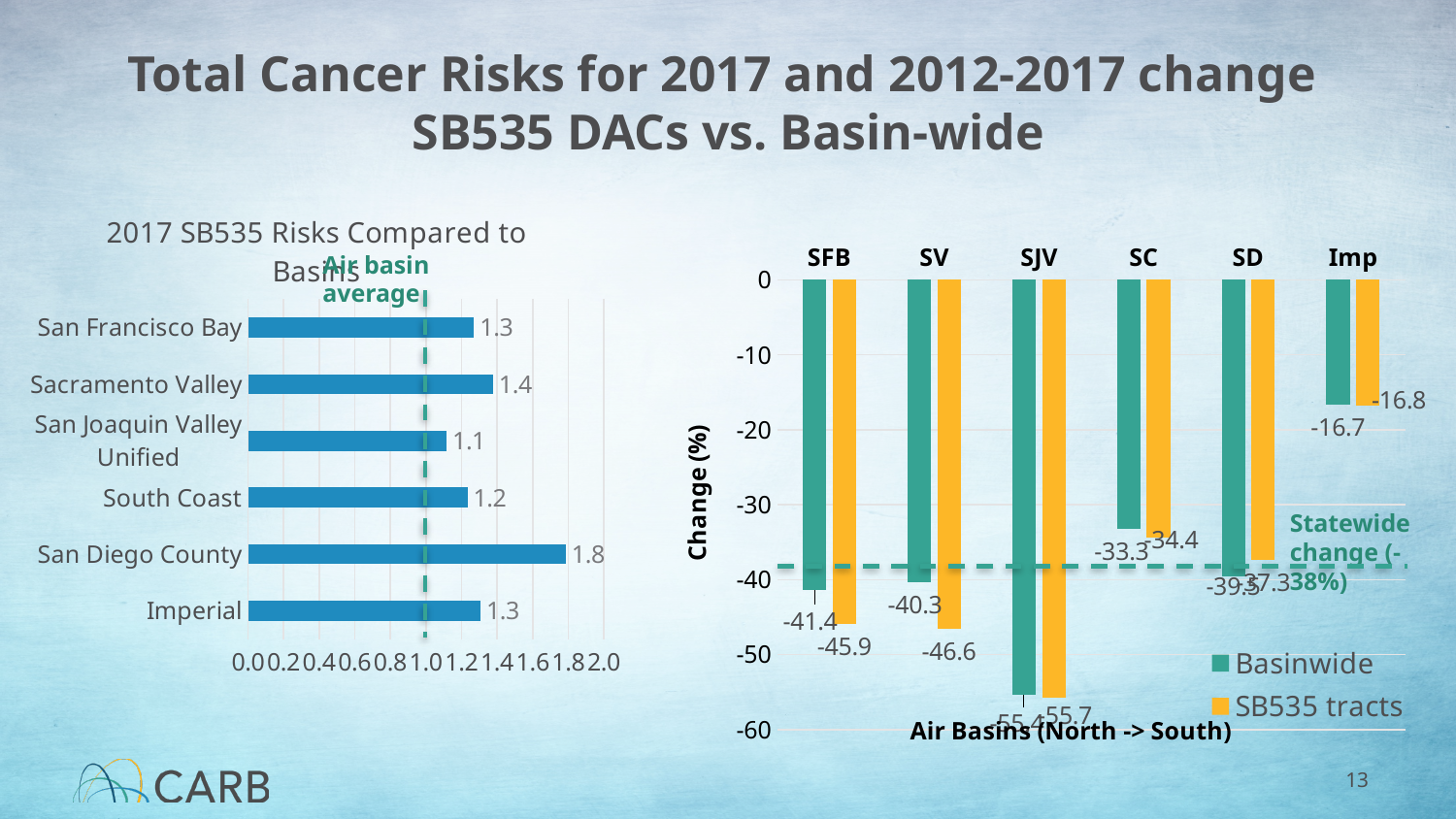
In the right chart of 2012-2017 change, which air basin has the largest decrease for SB535 tracts? SJV In the right chart of 2012-2017 change, what is the SB535 tracts value for SV? -46.6 In the left chart '2017 SB535 Risks Compared to Basins', which basin has the lowest value? San Joaquin Valley Unified In the right chart of 2012-2017 change, what is the Basinwide value for SFB? -41.4 What kind of chart is the left chart '2017 SB535 Risks Compared to Basins'? Bar chart In the right chart of 2012-2017 change, is the Basinwide value for SC greater or less than -30? less In the left chart '2017 SB535 Risks Compared to Basins', what is the value for San Diego County? 1.8 In the left chart '2017 SB535 Risks Compared to Basins', what is the difference between the values for San Diego County and South Coast? 0.6 In the right chart of 2012-2017 change, how many series does the legend list? 2 In the left chart '2017 SB535 Risks Compared to Basins', how many basins are plotted? 6 In the left chart '2017 SB535 Risks Compared to Basins', which basin has the highest value? San Diego County In the right chart of 2012-2017 change, what is the difference between the SB535 tracts and Basinwide values for SFB? 4.5